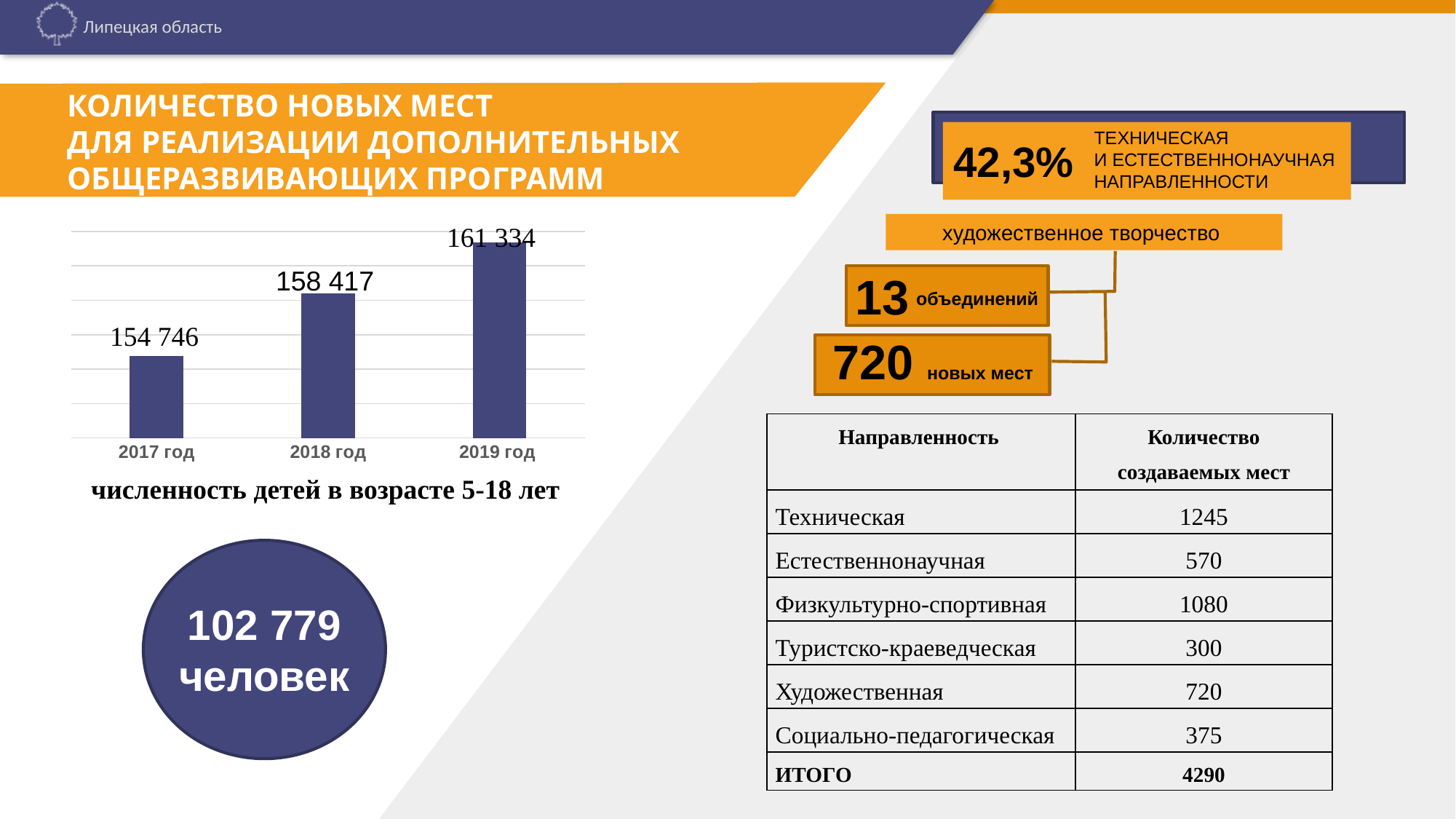
Do the values in the bar chart rise or fall from 2017 год to 2019 год? rise What is the value shown for 2018 год in the bar chart? 158 417 What is the difference between the values for 2019 год and 2018 год in the bar chart? 2 917 Which year has the lowest value in the bar chart? 2017 год What type of chart is shown on the slide? bar chart Which year has the highest value in the bar chart? 2019 год How many bars are shown in the bar chart? 3 What is the value shown for 2019 год in the bar chart? 161 334 What is the difference between the values for 2019 год and 2017 год in the bar chart? 6 588 What is the difference between the values for 2018 год and 2017 год in the bar chart? 3 671 What is the value shown for 2017 год in the bar chart? 154 746 Which is larger in the bar chart, the value for 2017 год or the value for 2018 год? 2018 год